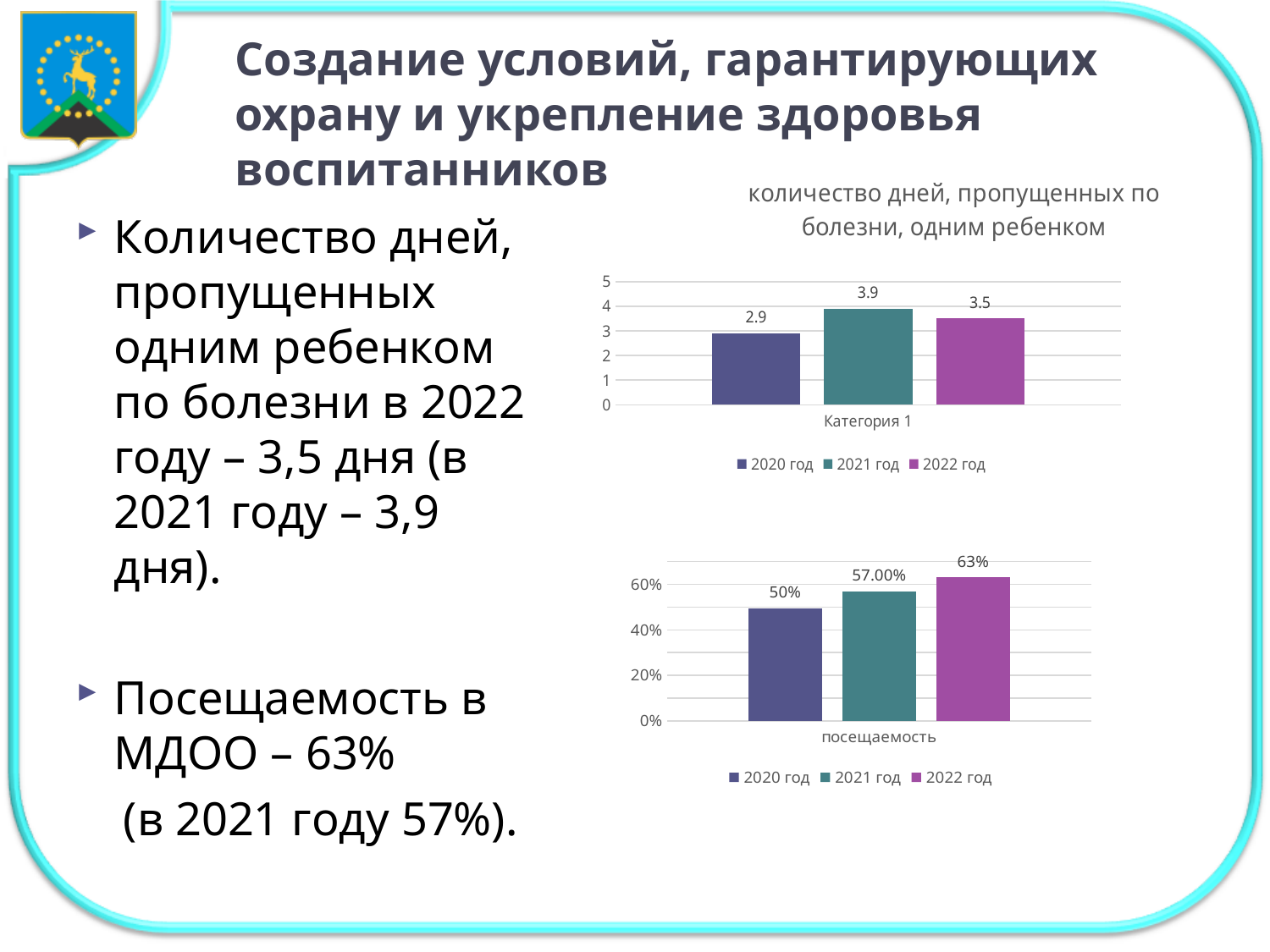
What kind of chart is the top chart titled "количество дней, пропущенных по болезни, одним ребенком"? bar chart In the bottom chart with the category "посещаемость", do the values rise or fall from 2020 год to 2022 год? rise In the bottom chart with the category "посещаемость", what is the value for 2022 год? 63% In the top chart titled "количество дней, пропущенных по болезни, одним ребенком", which series has the lowest value? 2020 год In the bottom chart with the category "посещаемость", which series has the lowest value? 2020 год In the top chart titled "количество дней, пропущенных по болезни, одним ребенком", what is the difference between the 2021 год and 2022 год values? 0.4 In the top chart titled "количество дней, пропущенных по болезни, одним ребенком", which series has the highest value? 2021 год In the top chart titled "количество дней, пропущенных по болезни, одним ребенком", what is the value for 2020 год? 2.9 In the bottom chart with the category "посещаемость", what is the value for 2021 год? 57.00% In the top chart titled "количество дней, пропущенных по болезни, одним ребенком", what is the value for 2021 год? 3.9 In the top chart titled "количество дней, пропущенных по болезни, одним ребенком", how many series does the legend list? 3 In the bottom chart with the category "посещаемость", which is larger, the value for 2020 год or the value for 2022 год? 2022 год